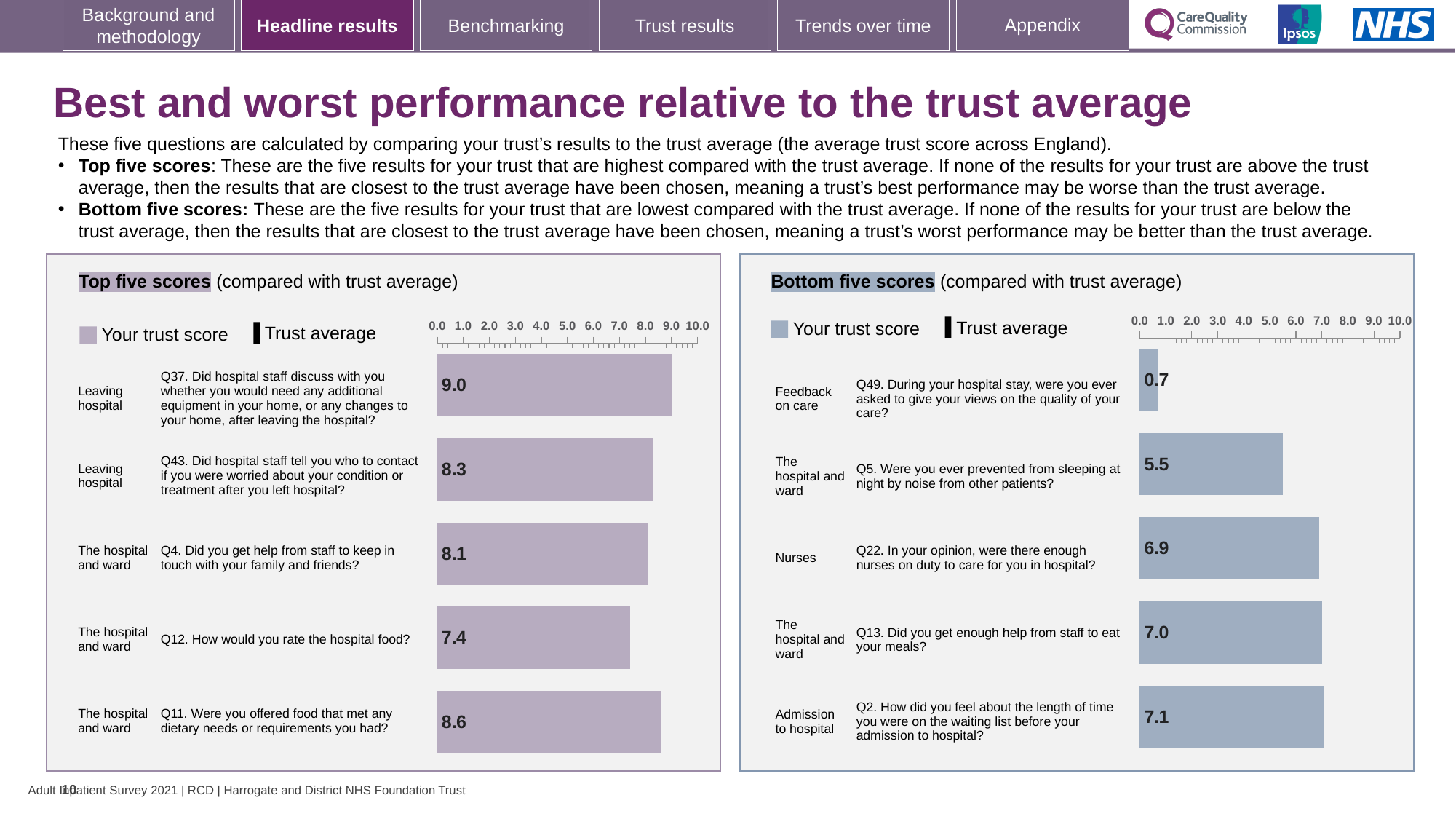
In the Top five scores chart, which question has the highest trust score? Q37 (9.0) How many entries does the legend of the Bottom five scores chart list? 2 In the Bottom five scores chart, which question has the lowest trust score? Q49 (0.7) What type of chart is used for the Top five scores? Bar chart In the Top five scores chart, what is the trust score for Q12, how would you rate the hospital food? 7.4 In the Top five scores chart, which question has the lowest trust score? Q12 (7.4) In the Top five scores chart, what is the difference between the scores for Q37 and Q43? 0.7 In the Bottom five scores chart, what is the trust score for Q49, about being asked to give your views on the quality of your care? 0.7 In the Top five scores chart, which has the higher score: Q4 or Q11? Q11 How many bars are plotted in the Bottom five scores chart? 5 In the Bottom five scores chart, what is the difference between the scores for Q2 and Q49? 6.4 In the Bottom five scores chart, which question has the highest trust score? Q2 (7.1)